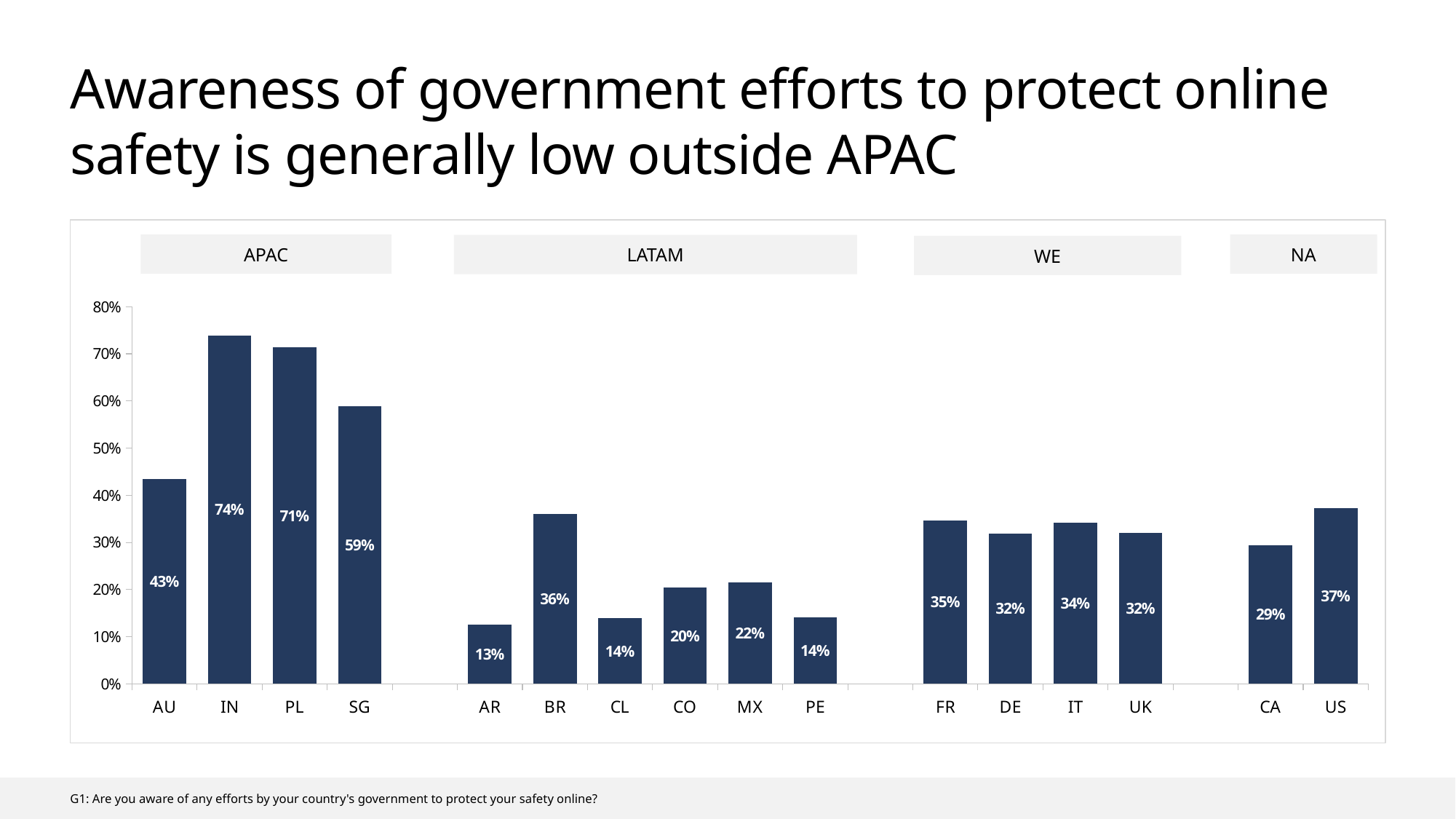
What is the value for BR? 36% Which is larger, the value for US or the value for FR? US Is the value for AU greater or less than 40%? greater Which country has the highest value? IN What is the difference between the values for MX and CL? 8% How many countries are shown on the chart? 16 What kind of chart is shown on the slide? bar chart What is the value for IN? 74% What is the difference between the values for PL and SG? 12% What is the value for CA? 29% Which country has the lowest value? AR How many regional groups are labelled above the chart? 4